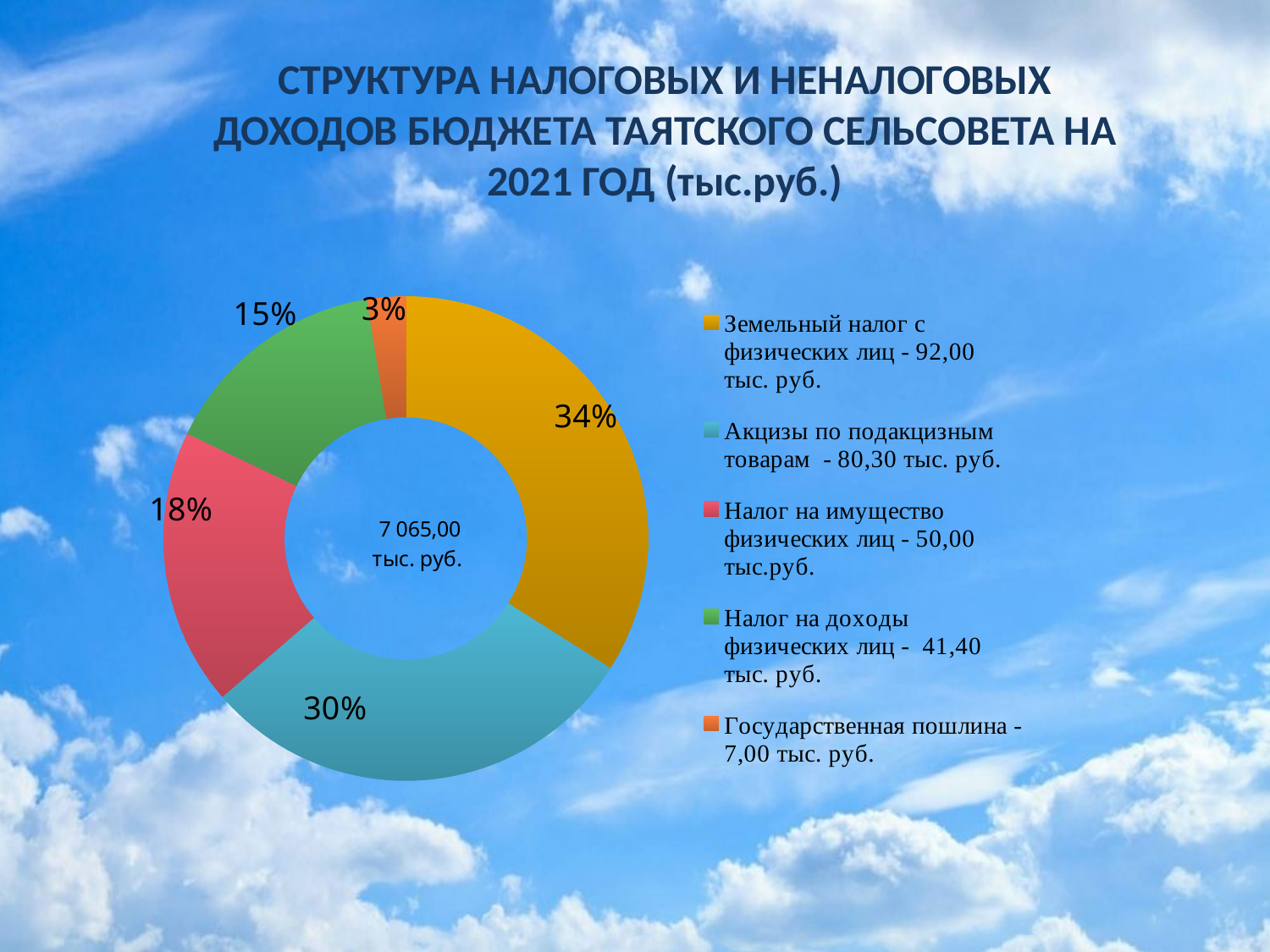
What share of the pie does Акцизы по подакцизным товарам represent? 30% Which has a larger share: Налог на имущество физических лиц or Налог на доходы физических лиц? Налог на имущество физических лиц What share of the pie does Налог на доходы физических лиц represent? 15% What is the difference in percentage points between the shares of Земельный налог с физических лиц and Акцизы по подакцизным товарам? 4 percentage points What kind of chart is shown on the slide? Doughnut (pie) chart What share of the pie does Налог на имущество физических лиц represent? 18% Which category has the largest share of the pie? Земельный налог с физических лиц What value is printed in the centre of the doughnut chart? 7 065,00 тыс. руб. How many categories are shown in the chart? 5 Which category has the smallest share of the pie? Государственная пошлина